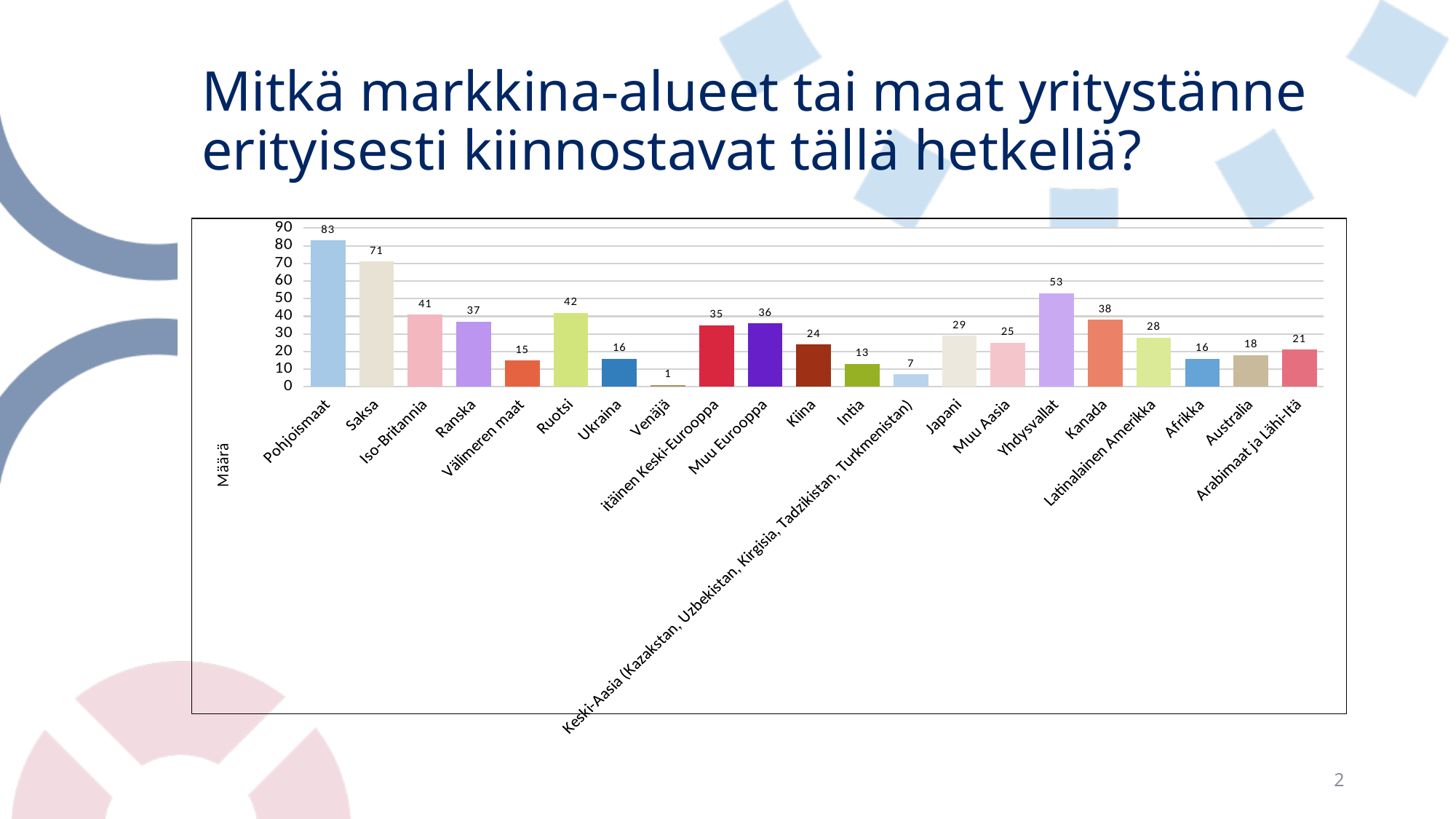
What is the value for Pohjoismaat? 83 What is the value for Arabimaat ja Lähi-Itä? 21 How many categories are shown on the x axis? 21 What is the difference between the values for Saksa and Kanada? 33 Which category has the lowest value? Venäjä What is the label of the vertical axis? Määrä Which is larger, the value for Ruotsi or the value for Iso-Britannia? Ruotsi What kind of chart is shown on the slide? Bar chart Is the value for Japani greater or less than 20? greater Which category has the highest value? Pohjoismaat What is the value for Keski-Aasia (Kazakstan, Uzbekistan, Kirgisia, Tadzikistan, Turkmenistan)? 7 What is the value for Yhdysvallat? 53